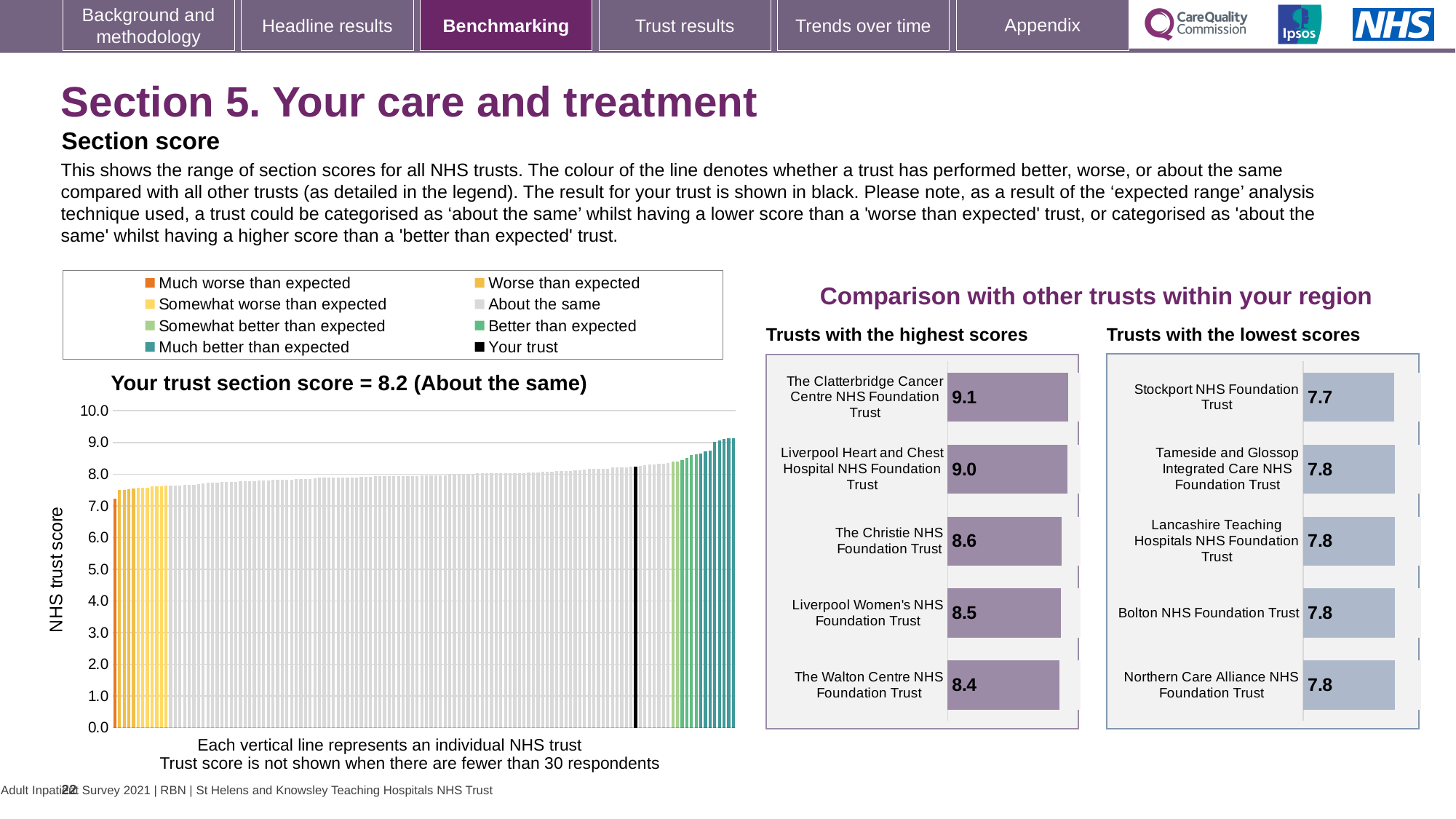
In the 'Trusts with the highest scores' chart, what is the score for The Christie NHS Foundation Trust? 8.6 In the 'Your trust section score' chart, what is the section score for your trust? 8.2 What kind of chart is the 'Your trust section score' chart on the left of the slide? bar chart In the 'Your trust section score' chart, do the bar heights rise or fall from left to right along the x axis? rise How many entries does the legend above the 'Your trust section score' chart list? 8 What is the y-axis label of the 'Your trust section score' chart? NHS trust score In the 'Trusts with the highest scores' chart, which trust has the highest score? The Clatterbridge Cancer Centre NHS Foundation Trust In the 'Trusts with the highest scores' chart, what is the difference between the scores of The Clatterbridge Cancer Centre NHS Foundation Trust and The Walton Centre NHS Foundation Trust? 0.7 In the 'Trusts with the highest scores' chart, how many trusts are shown? 5 In the 'Trusts with the highest scores' chart, which has the larger score: The Christie NHS Foundation Trust or Liverpool Women's NHS Foundation Trust? The Christie NHS Foundation Trust In the 'Trusts with the lowest scores' chart, what is the score for Bolton NHS Foundation Trust? 7.8 In the 'Trusts with the lowest scores' chart, which trust has the lowest score? Stockport NHS Foundation Trust